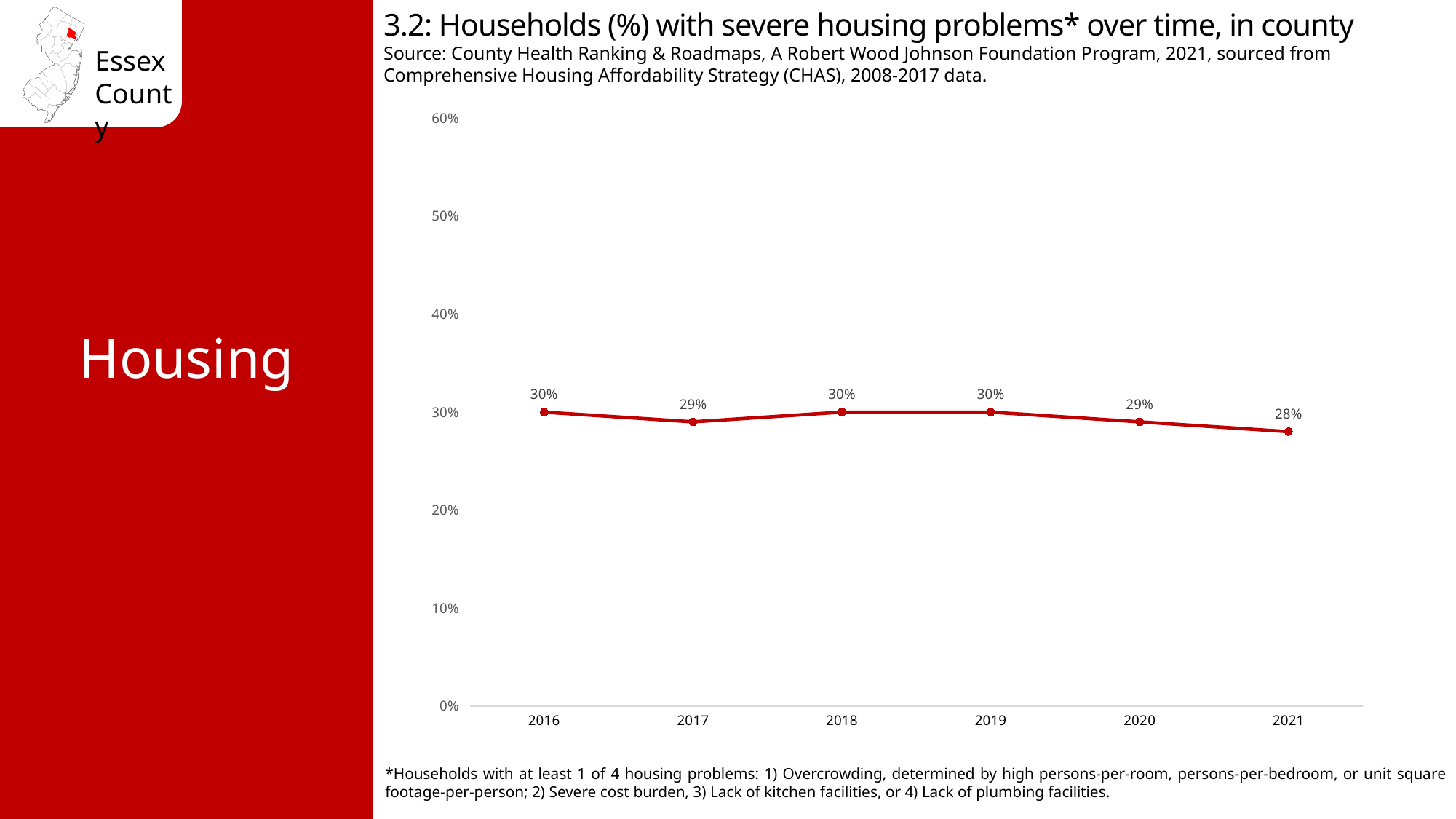
What is the value shown for 2020? 29% Does the value rise or fall from 2019 to 2021? fall What is the title of the chart? 3.2: Households (%) with severe housing problems* over time, in county What percentage of households had severe housing problems in 2016? 30% Is the value for 2019 greater or less than 40%? less Which year has the lowest value on the chart? 2021 What is the highest value shown on the y axis? 60% How many years are plotted on the chart? 6 What is the value shown for 2021? 28% Which is larger, the value for 2018 or the value for 2017? 2018 What is the difference between the 2016 value and the 2021 value? 2% What kind of chart is shown on the slide? line chart